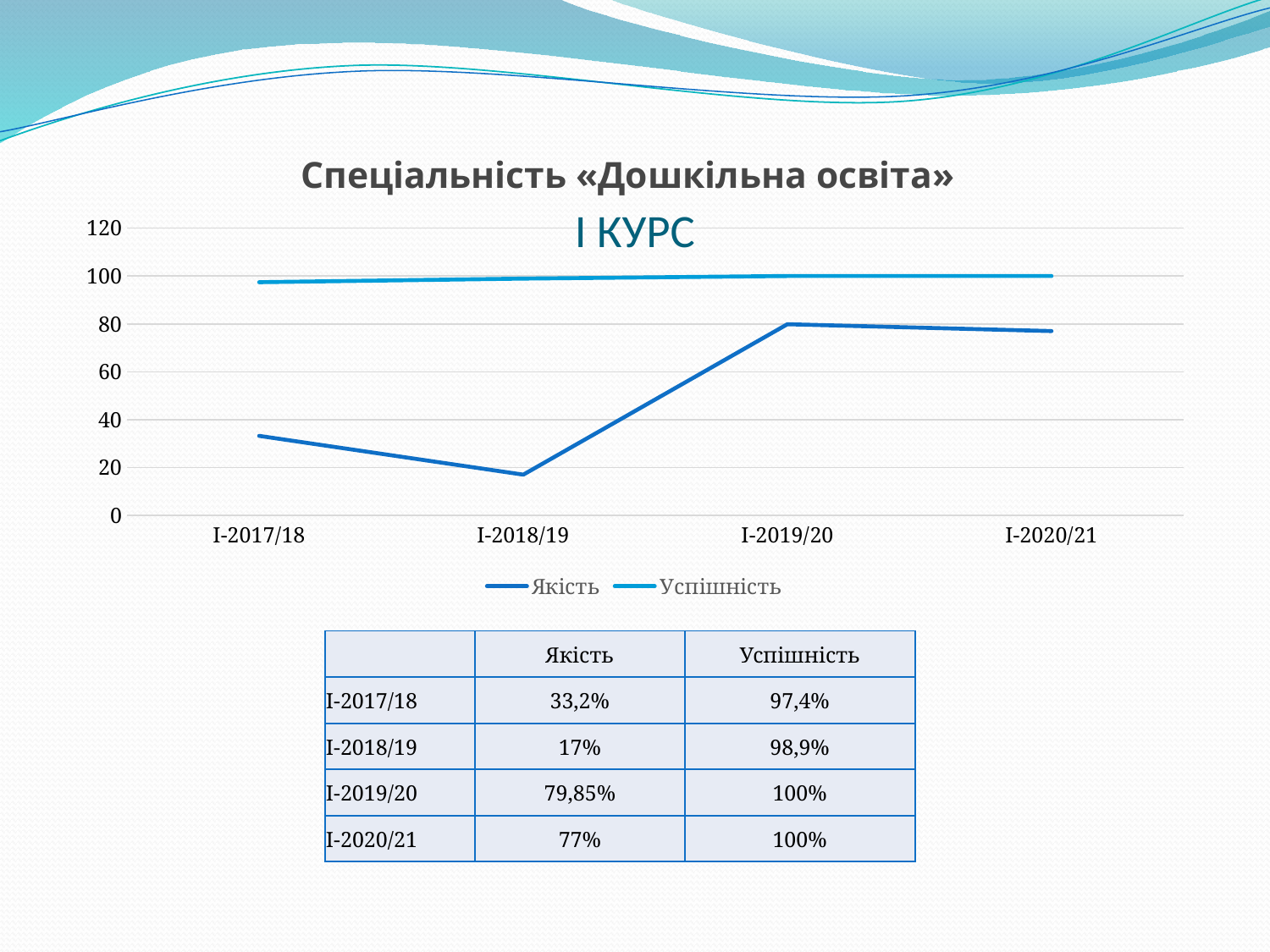
Is the value of Якість for І-2017/18 greater or less than 40? less What is the difference between Успішність and Якість for І-2020/21? 23% In which period is Якість highest? І-2019/20 How many series does the chart legend list? 2 What kind of chart is shown on the slide? line chart Which is larger for І-2017/18: Якість or Успішність? Успішність Does Якість rise or fall from І-2018/19 to І-2019/20? rise What is the value of Якість for І-2019/20? 79,85% What is the value of Якість for І-2018/19? 17% How many periods are plotted along the x axis of the chart? 4 What is the value of Успішність for І-2017/18? 97,4% In which period is Якість lowest? І-2018/19